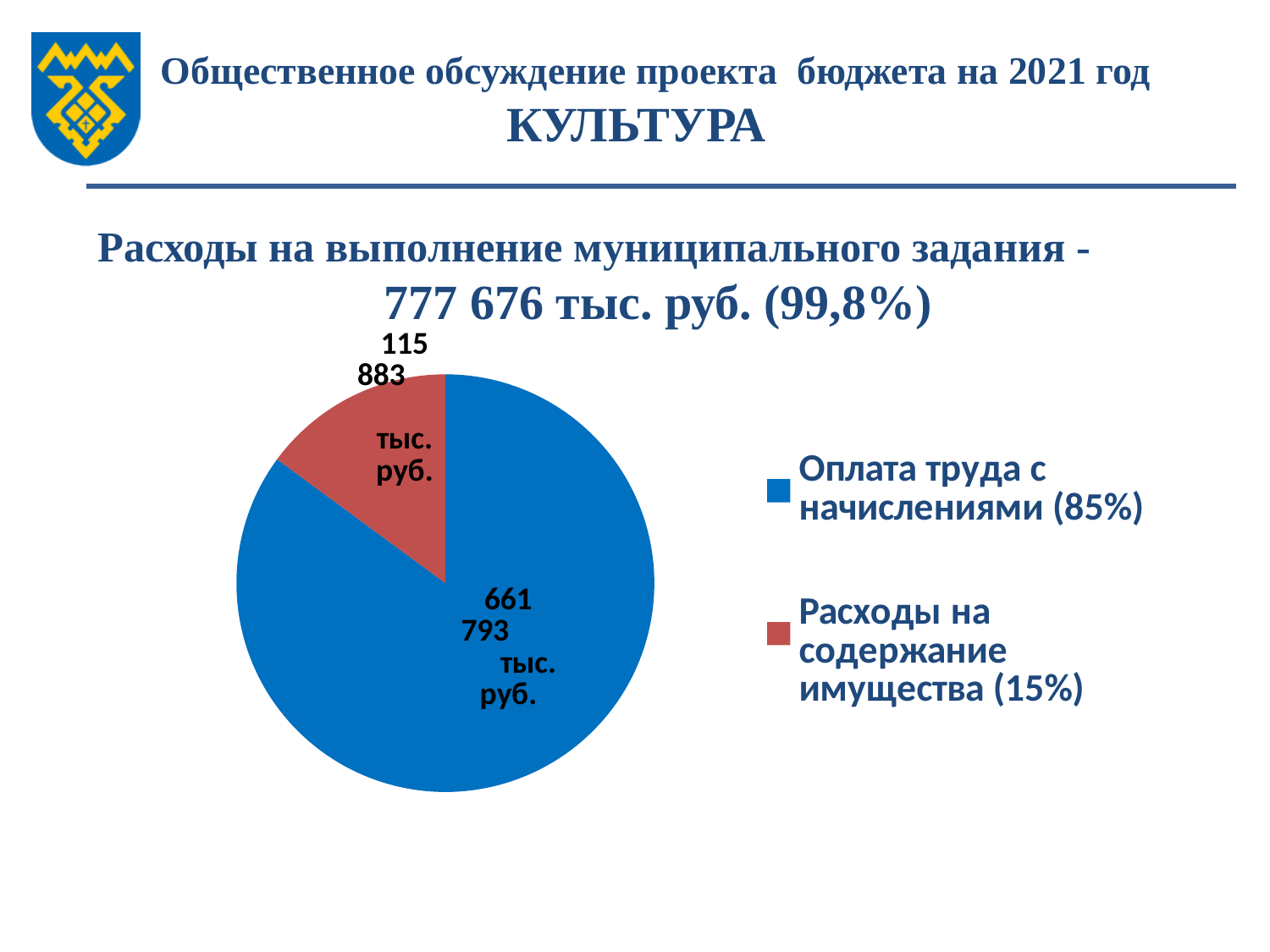
How many entries does the legend list? 2 Which category has the smallest slice of the pie? Расходы на содержание имущества Which category has the largest slice of the pie? Оплата труда с начислениями Which is larger: "Оплата труда с начислениями" or "Расходы на содержание имущества"? Оплата труда с начислениями What is the difference between the value for "Оплата труда с начислениями" and the value for "Расходы на содержание имущества"? 545 910 тыс. руб. What colour is the slice for "Расходы на содержание имущества"? red What share of the pie does "Оплата труда с начислениями" represent? 85% How many slices does the pie chart have? 2 What share of the pie does "Расходы на содержание имущества" represent? 15% What is the value for "Оплата труда с начислениями"? 661 793 тыс. руб. What is the value for "Расходы на содержание имущества"? 115 883 тыс. руб. What kind of chart is shown on the slide? pie chart